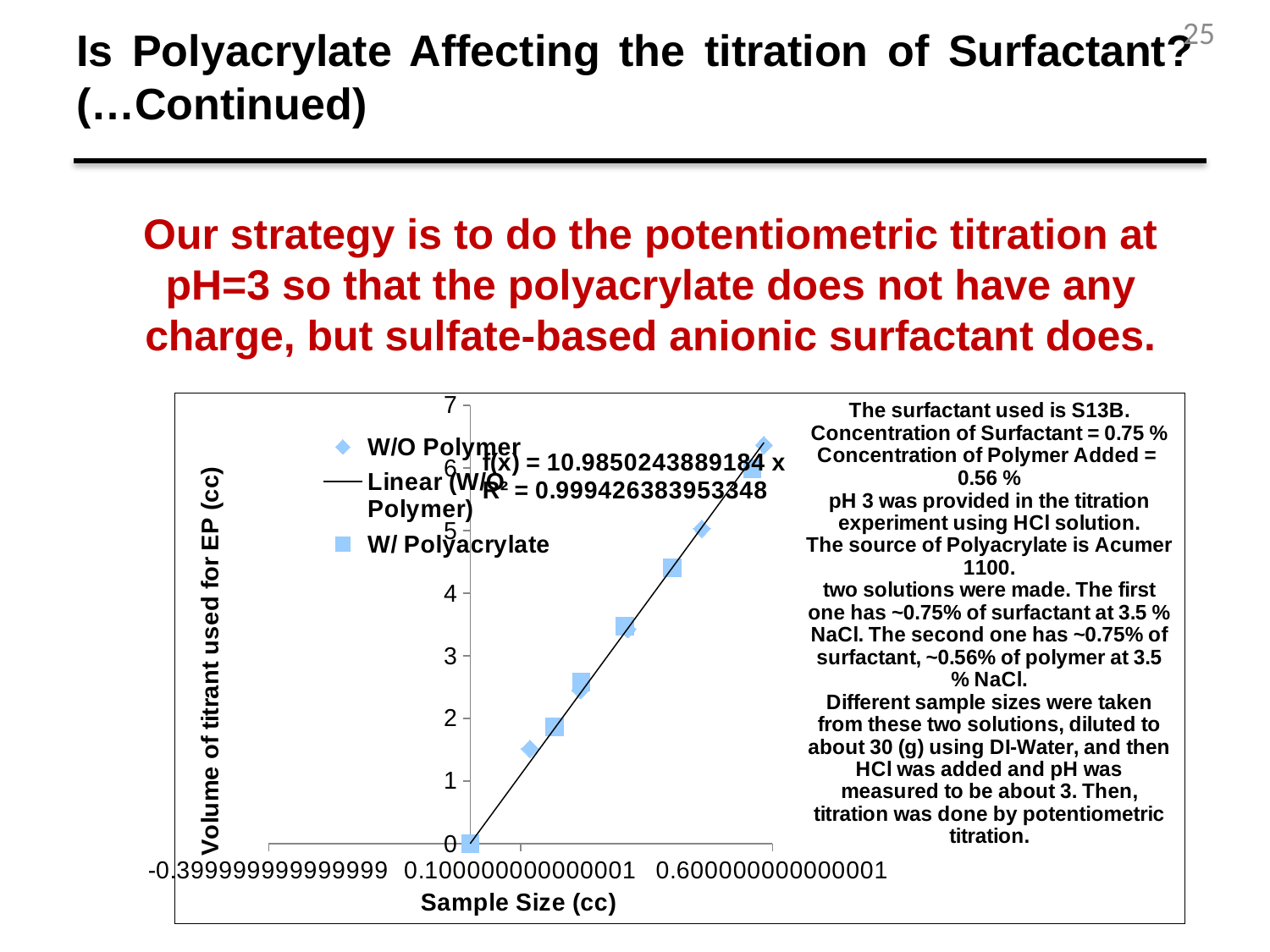
Is the volume of titrant for the points at a sample size of about 0.3 cc greater or less than 2? greater What is the maximum value shown on the y axis of the chart? 7 What is the title of the y axis of the chart? Volume of titrant used for EP (cc) What kind of chart is shown on the slide? scatter chart What is the R² value shown for the linear trendline on the chart? 0.999426383953348 How many entries does the chart legend list? 3 Is the volume of titrant for the points at a sample size of about 0.5 cc greater or less than 4? greater Is the highest plotted volume of titrant on the chart greater or less than 6? greater What is the trendline equation shown on the chart? f(x) = 10.9850243889184 x Do the plotted values rise or fall as sample size increases along the x axis? rise What is the title of the x axis of the chart? Sample Size (cc)